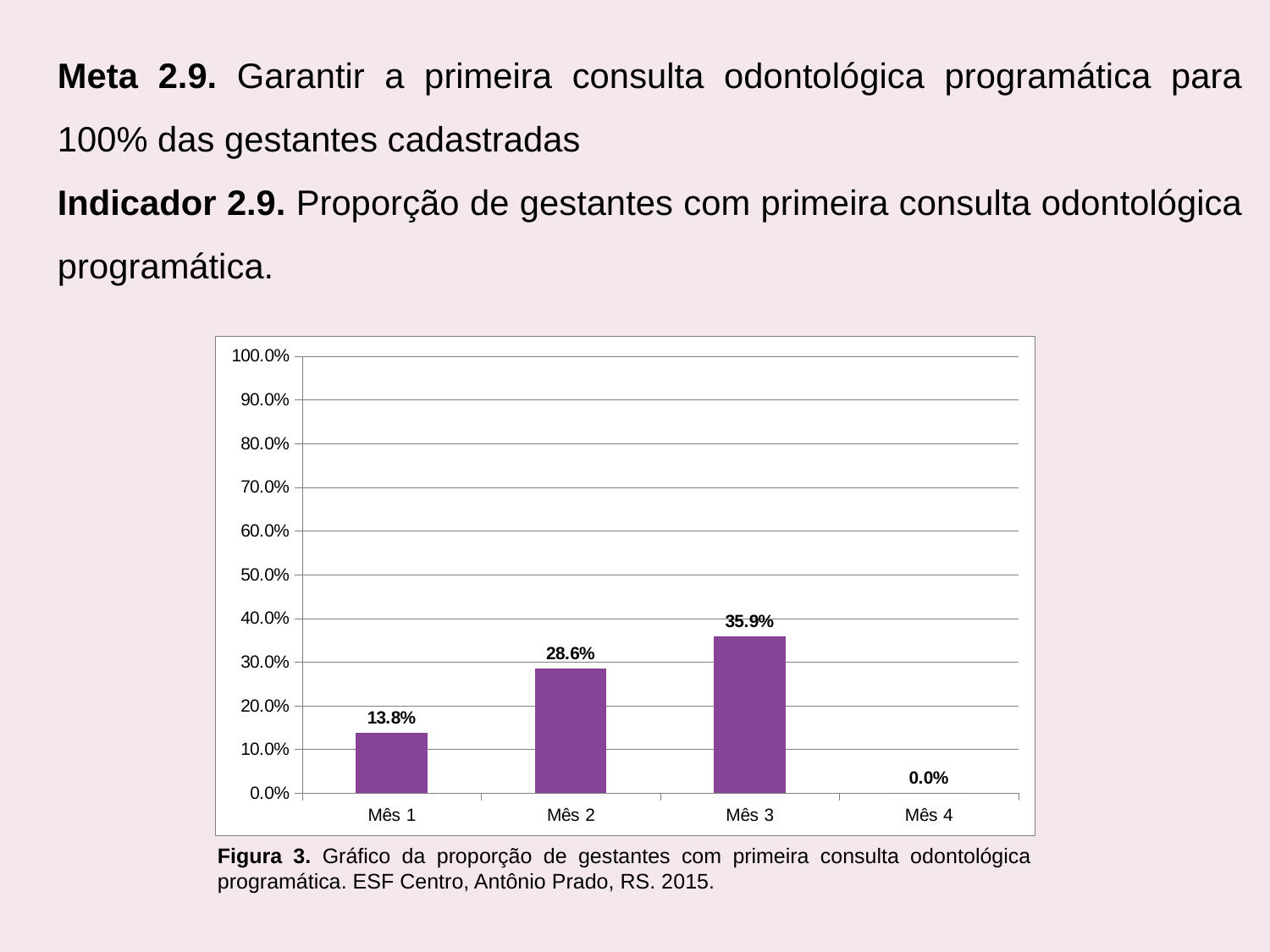
What is the value for Mês 1? 13.8% Is the value for Mês 3 greater or less than 40.0%? less What is the value for Mês 2? 28.6% What is the value for Mês 3? 35.9% Which month has the highest value? Mês 3 What kind of chart is shown on the slide? bar chart What is the difference between the values for Mês 3 and Mês 1? 22.1% How many months are shown on the x axis? 4 What is the figure number given in the caption below the chart? Figura 3 Which month has the lowest value? Mês 4 Which is larger, the value for Mês 2 or the value for Mês 1? Mês 2 What is the value for Mês 4? 0.0%